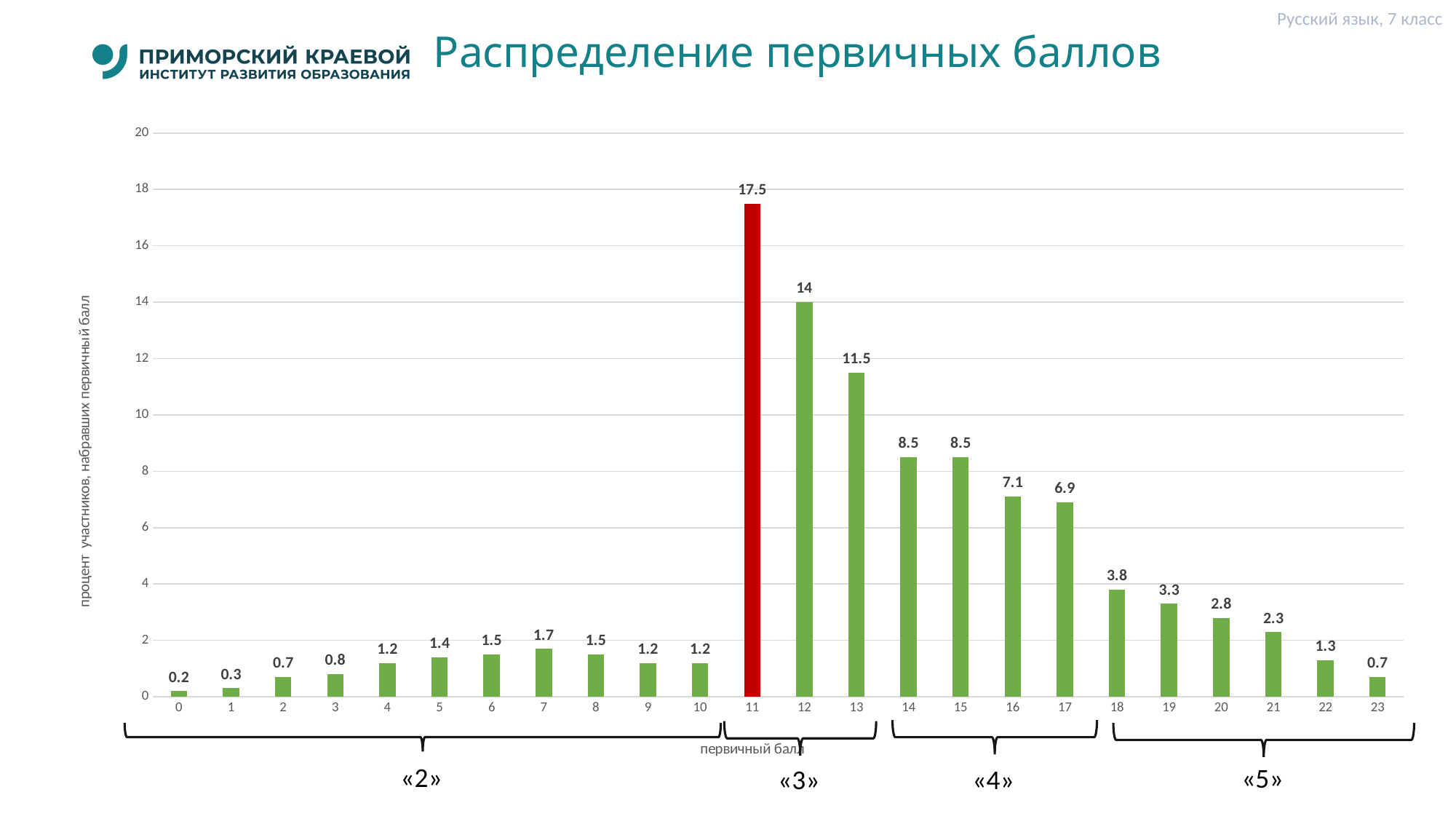
What is the difference between the values for primary scores 12 and 13? 2.5 What is the value for primary score 17? 6.9 Which primary score has the lowest percentage of participants? 0 Is the value for primary score 13 greater or less than 10? greater How many primary score categories are shown on the x axis? 24 What is the value for primary score 11? 17.5 What kind of chart is shown on the slide? bar chart Which is larger, the value for primary score 7 or the value for primary score 22? 7 Which primary score has the highest percentage of participants? 11 Which bar is coloured red rather than green? 11 What is the value for primary score 20? 2.8 What is the difference between the values for primary scores 11 and 12? 3.5